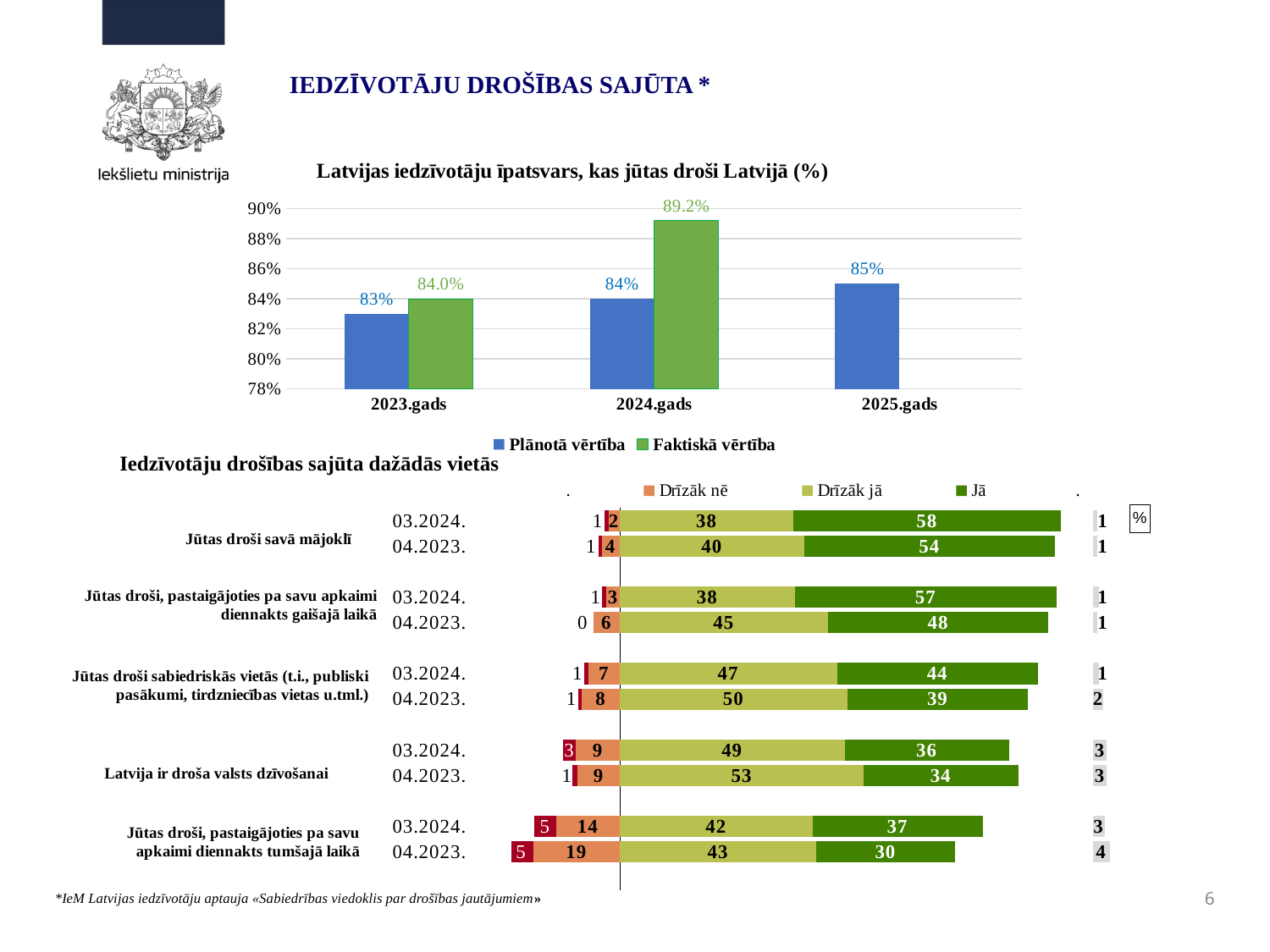
In the top chart 'Latvijas iedzīvotāju īpatsvars, kas jūtas droši Latvijā (%)', how many series does the legend list? 2 In the top chart 'Latvijas iedzīvotāju īpatsvars, kas jūtas droši Latvijā (%)', what type of chart is it? bar chart In the bottom chart 'Iedzīvotāju drošības sajūta dažādās vietās', what is the 'Drīzāk nē' value for 'Jūtas droši, pastaigājoties pa savu apkaimi diennakts tumšajā laikā' in 04.2023.? 19 In the bottom chart 'Iedzīvotāju drošības sajūta dažādās vietās', which is larger: the 'Jā' value for 'Jūtas droši sabiedriskās vietās' in 03.2024. or in 04.2023.? 03.2024. In the top chart 'Latvijas iedzīvotāju īpatsvars, kas jūtas droši Latvijā (%)', which year has the highest Faktiskā vērtība? 2024.gads In the bottom chart 'Iedzīvotāju drošības sajūta dažādās vietās', what is the 'Drīzāk jā' value for 'Latvija ir droša valsts dzīvošanai' in 04.2023.? 53 In the bottom chart 'Iedzīvotāju drošības sajūta dažādās vietās', what is the difference between the 'Jā' values for 'Jūtas droši, pastaigājoties pa savu apkaimi diennakts gaišajā laikā' in 03.2024. and 04.2023.? 9 In the top chart 'Latvijas iedzīvotāju īpatsvars, kas jūtas droši Latvijā (%)', does the Plānotā vērtība rise or fall from 2023.gads to 2025.gads? rise In the top chart 'Latvijas iedzīvotāju īpatsvars, kas jūtas droši Latvijā (%)', what is the Faktiskā vērtība for 2024.gads? 89.2% In the top chart 'Latvijas iedzīvotāju īpatsvars, kas jūtas droši Latvijā (%)', what is the Faktiskā vērtība for 2023.gads? 84.0% In the bottom chart 'Iedzīvotāju drošības sajūta dažādās vietās', what is the 'Jā' value for 'Jūtas droši savā mājoklī' in 03.2024.? 58 In the top chart 'Latvijas iedzīvotāju īpatsvars, kas jūtas droši Latvijā (%)', what is the Plānotā vērtība for 2025.gads? 85%